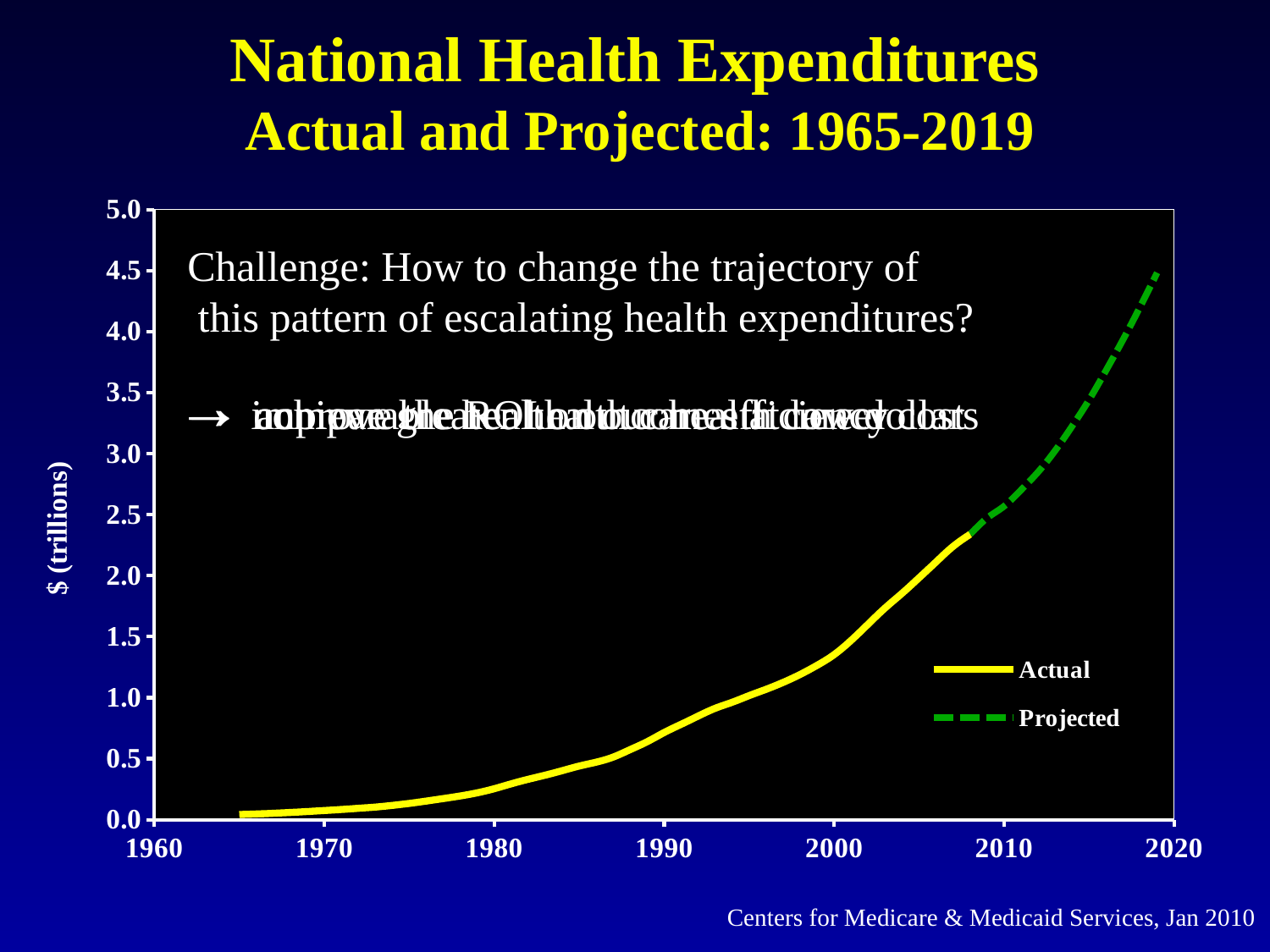
Is the projected value for 2019 greater or less than 4.0? greater Do national health expenditures rise or fall from 1965 to 2019? rise Is the value for 2000 greater or less than 1.5? less What is the label on the y axis? $ (trillions) Is the value for 2000 greater or less than 1.0? greater What are the two series named in the legend? Actual and Projected Which is larger, the value for 2000 or the value for 1990? 2000 What kind of chart is shown on the slide? line chart How many series does the legend list? 2